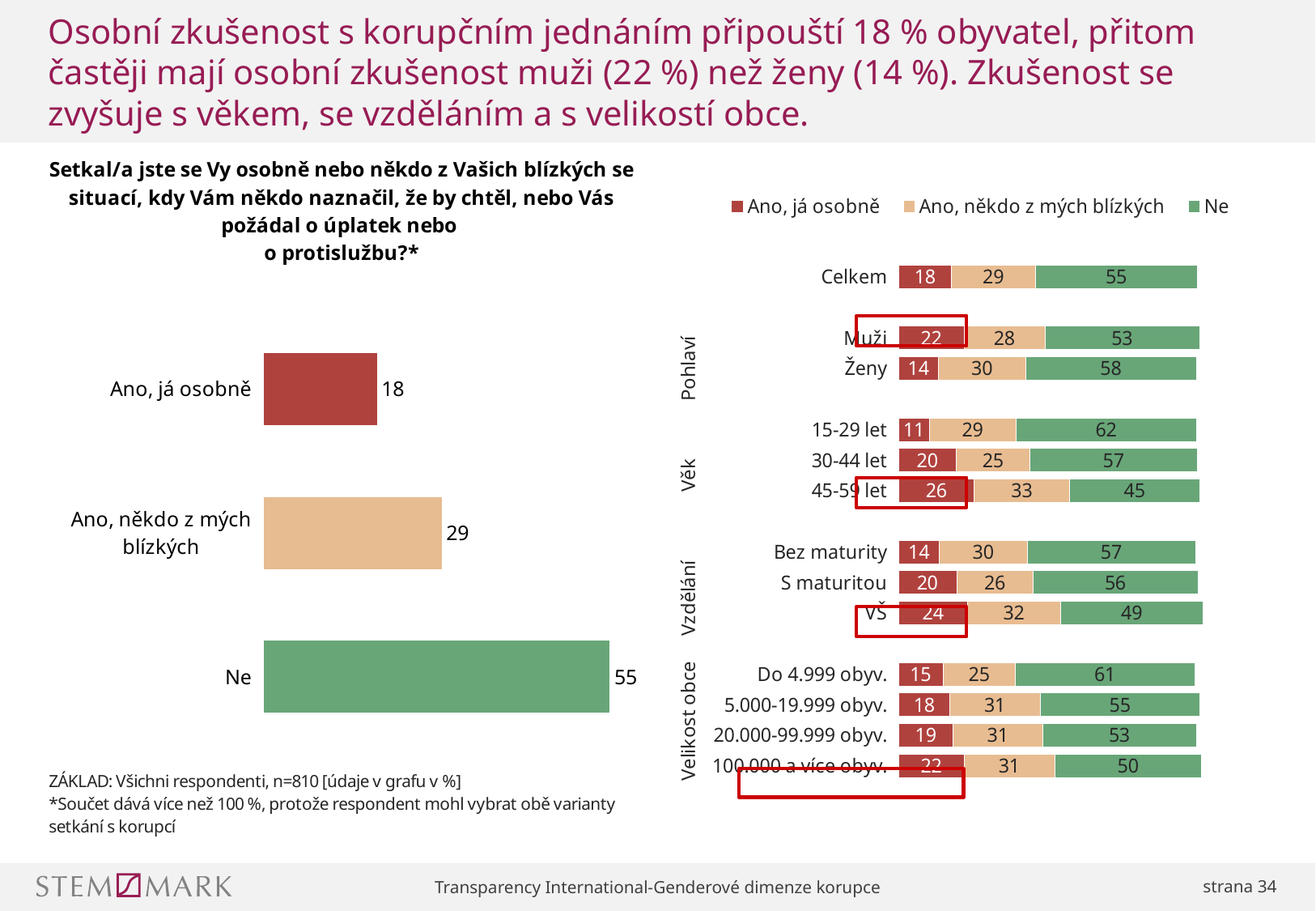
In the right stacked chart, what is the "Ne" value for "45-59 let"? 45 In the right stacked chart, which is larger: the "Ano, já osobně" value for "Muži" or for "Ženy"? Muži In the left chart, what is the difference between the values for "Ne" and "Ano, někdo z mých blízkých"? 26 In the left chart, what is the value for "Ne"? 55 In the right stacked chart, what is the "Ano, někdo z mých blízkých" value for "VŠ"? 32 What kind of chart is the left chart? bar chart In the left chart, which category has the lowest value? Ano, já osobně In the right stacked chart, what is the difference between the "Ne" values for "15-29 let" and "45-59 let"? 17 In the left chart, how many bars are plotted? 3 In the right stacked chart, which category has the highest "Ano, já osobně" value? 45-59 let In the right stacked chart, what is the "Ano, já osobně" value for "Muži"? 22 How many series does the legend of the right stacked chart list? 3